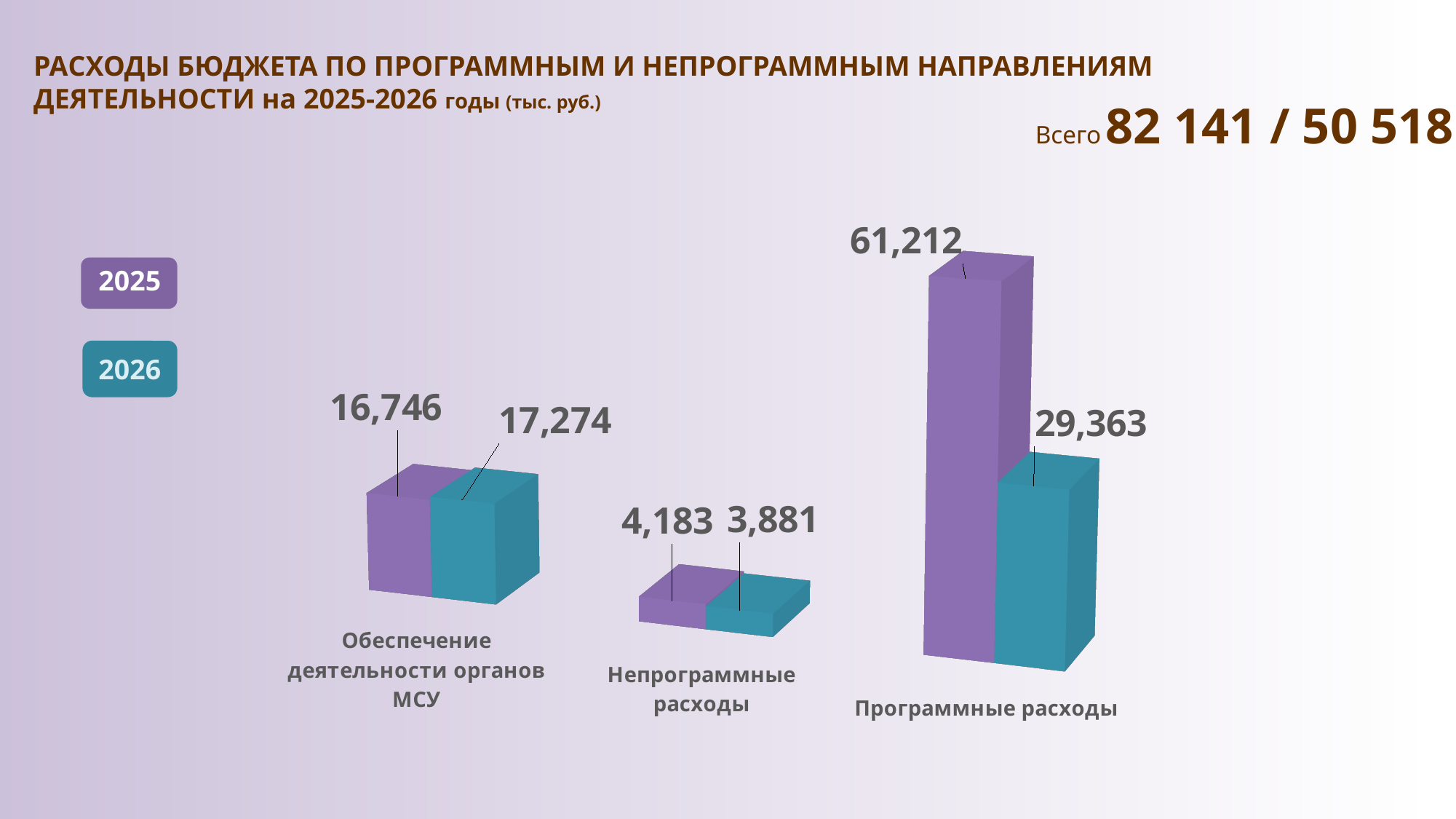
Какое значение показано для категории «Непрограммные расходы» за 2026 год? 3,881 На сколько значение «Программные расходы» за 2025 год больше значения за 2026 год? 31,849 Какого типа эта диаграмма? Столбчатая (bar chart) Сколько рядов данных (годов) показано в легенде? 2 Какое значение показано для категории «Программные расходы» за 2025 год? 61,212 Что больше: «Непрограммные расходы» за 2025 год или за 2026 год? 2025 год Сколько категорий показано на диаграмме? 3 Какое значение показано для категории «Обеспечение деятельности органов МСУ» за 2026 год? 17,274 Каким цветом обозначен 2026 год в легенде? Бирюзовым (сине-зелёным) Какая категория имеет наименьшее значение за 2026 год? Непрограммные расходы На сколько значение «Обеспечение деятельности органов МСУ» за 2026 год больше значения за 2025 год? 528 Какая категория имеет наибольшее значение за 2025 год? Программные расходы